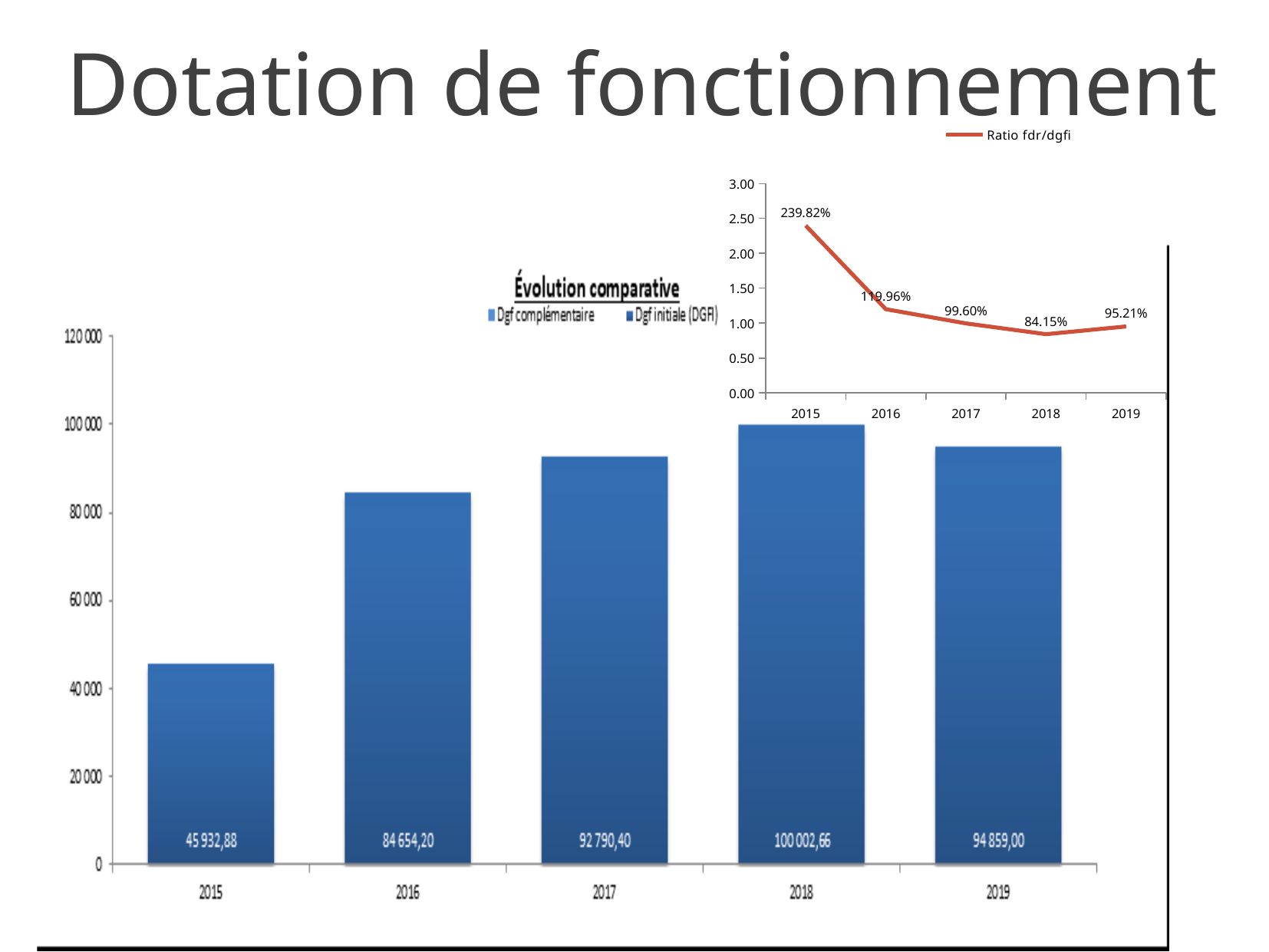
In the 'Évolution comparative' bar chart, how many years are shown on the x axis? 5 In the 'Ratio fdr/dgfi' line chart, what is the value for 2018? 84.15% In the 'Ratio fdr/dgfi' line chart, which year has the lowest value? 2018 In the 'Évolution comparative' bar chart, which year has the lowest value? 2015 In the 'Évolution comparative' bar chart, what is the value for 2015? 45 932,88 In the 'Évolution comparative' bar chart, is the value for 2016 larger or smaller than the value for 2017? smaller In the 'Ratio fdr/dgfi' line chart, what is the value for 2015? 239.82% How many series does the legend of the 'Évolution comparative' chart list? 2 In the 'Ratio fdr/dgfi' line chart, do the values rise or fall from 2015 to 2018? fall In the 'Évolution comparative' bar chart, what is the value for 2018? 100 002,66 In the 'Évolution comparative' bar chart, which year has the highest value? 2018 What kind of chart is the 'Ratio fdr/dgfi' chart in the top right? line chart